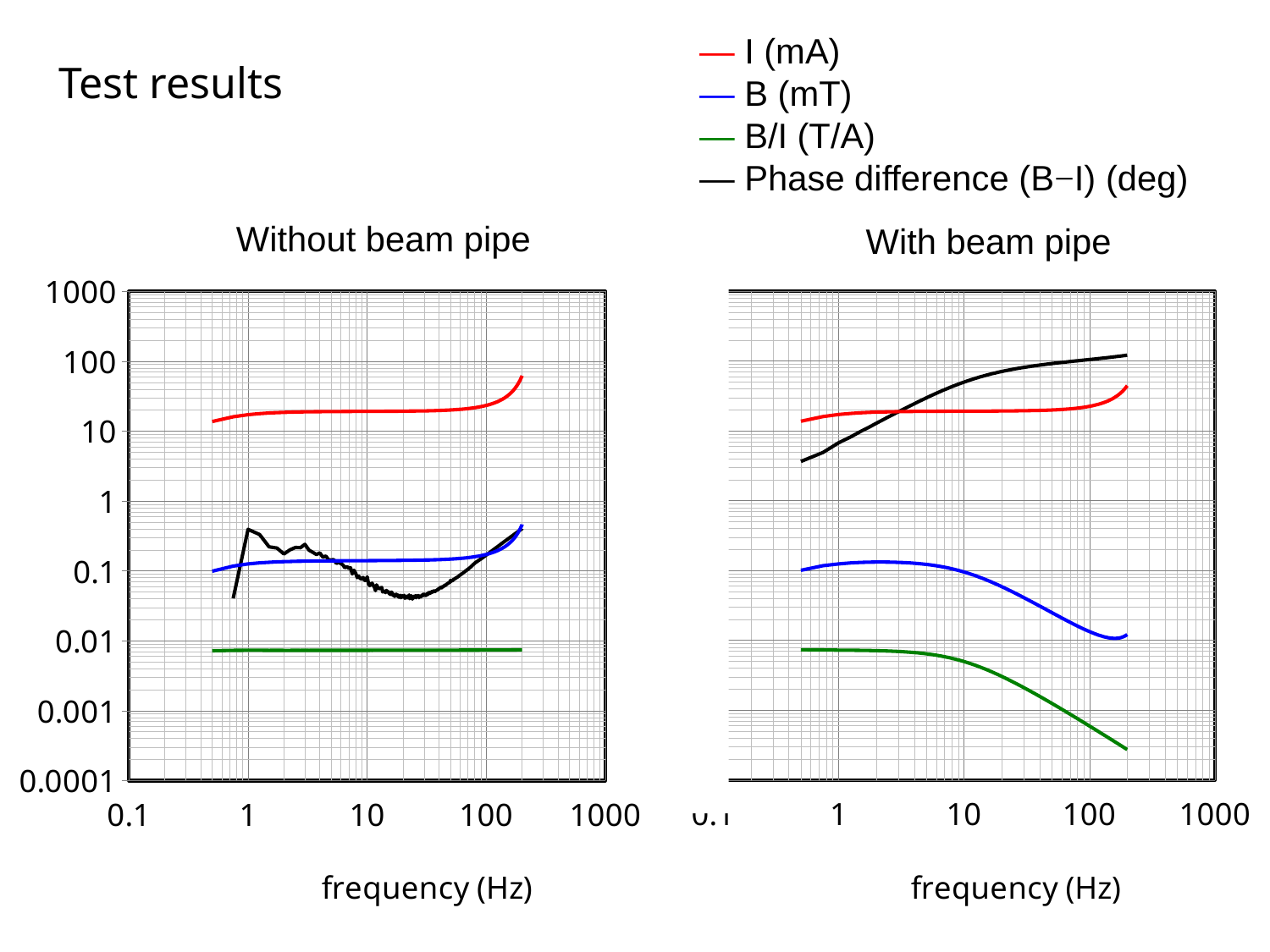
In the 'Without beam pipe' chart, which is larger at 10 Hz, I (mA) or B (mT)? I (mA) In the 'With beam pipe' chart, is the value of B/I (T/A) at 1 Hz greater or less than 0.001? greater In the 'Without beam pipe' chart, which series has the lowest values across the whole frequency range? B/I (T/A) What is the x-axis label on the 'With beam pipe' chart? frequency (Hz) In the 'Without beam pipe' chart, is the value of I (mA) at 10 Hz greater or less than 10? greater In the 'With beam pipe' chart, does B/I (T/A) rise or fall as frequency increases from 10 Hz to 200 Hz? fall In the 'With beam pipe' chart, does the phase difference (B−I) rise or fall as frequency increases? rise In the 'With beam pipe' chart, is the phase difference (B−I) at 100 Hz greater or less than 10? greater What is the title of the right-hand chart? With beam pipe What kind of chart is the 'Without beam pipe' chart? line chart How many series does the legend list? 4